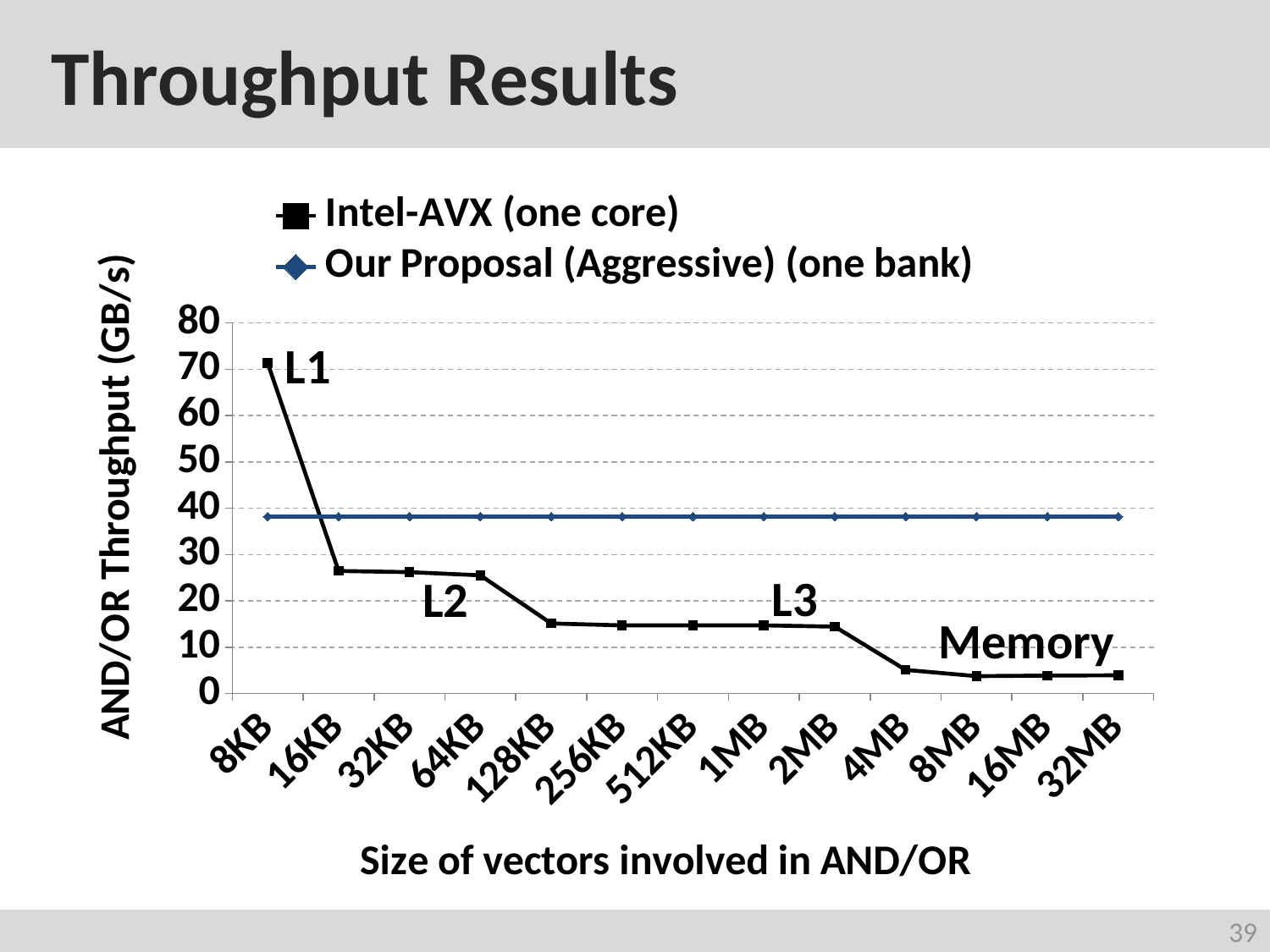
Is the Our Proposal (Aggressive) (one bank) value at 1MB greater or less than 30? greater What kind of chart is shown on the slide? line chart Does the Intel-AVX (one core) throughput rise or fall as the vector size increases along the x axis? fall Is the Intel-AVX (one core) value at 8MB greater or less than 10? less Is the Intel-AVX (one core) value at 16KB greater or less than 30? less At 2MB, which series has the higher throughput: Intel-AVX (one core) or Our Proposal (Aggressive) (one bank)? Our Proposal (Aggressive) (one bank) At which vector size is the Intel-AVX (one core) throughput highest? 8KB How many series does the legend list? 2 How many vector sizes are shown along the x axis? 13 At 8KB, which series has the higher throughput: Intel-AVX (one core) or Our Proposal (Aggressive) (one bank)? Intel-AVX (one core) What is the label of the y axis? AND/OR Throughput (GB/s)